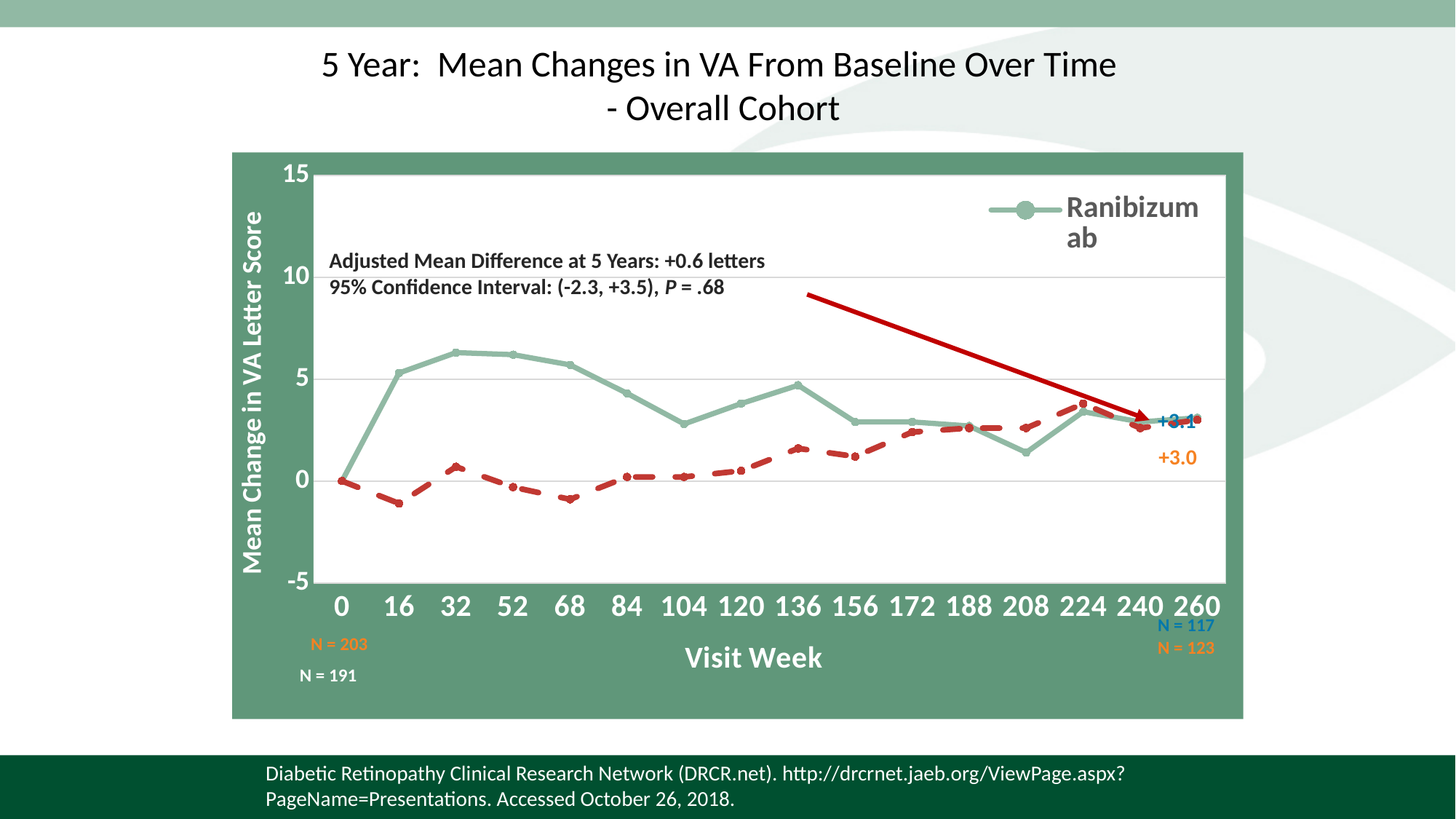
At which visit week is the Ranibizumab value lowest? 0 How many visit weeks are marked along the x axis? 16 Does the Ranibizumab line rise or fall between visit week 0 and visit week 32? rise Which series is named in the chart legend? Ranibizumab Is the Ranibizumab value at visit week 32 greater or less than 5? greater What is the Ranibizumab mean change in VA letter score at visit week 0? 0 Is the Ranibizumab value at visit week 104 greater or less than 5? less What kind of chart is shown on the slide? line chart Which is larger for Ranibizumab: the value at visit week 16 or the value at visit week 104? visit week 16 How many series does the chart legend list? 1 What adjusted mean difference at 5 years is stated on the chart? +0.6 letters Is the Ranibizumab value at visit week 208 greater or less than 5? less